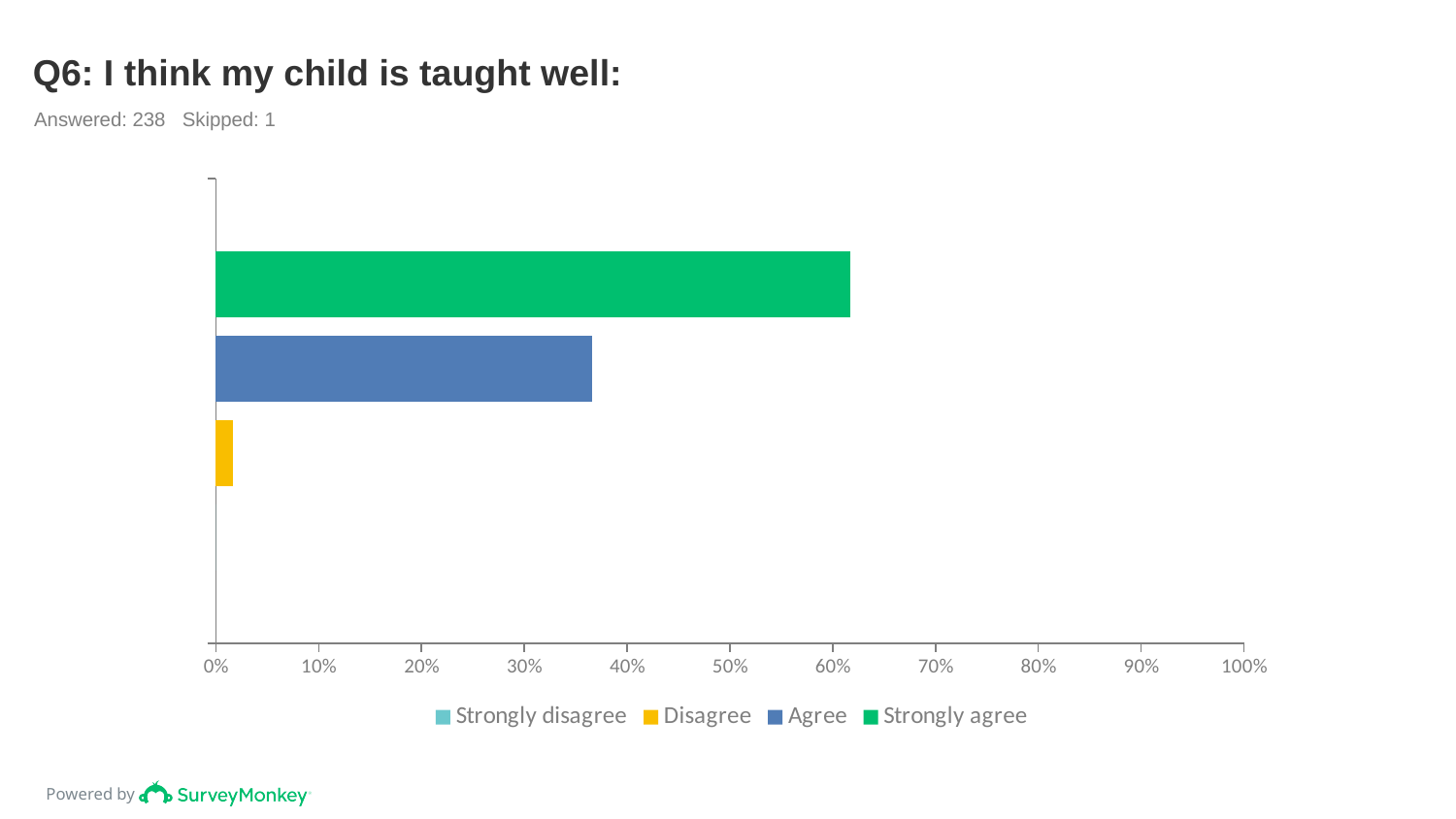
Which is larger, the value for Agree or the value for Strongly agree? Strongly agree Is the value for Disagree greater or less than 10%? less What is the title of the chart? Q6: I think my child is taught well: What kind of chart is shown on the slide? bar chart Is the value for Agree greater or less than 40%? less What colour is the bar for Strongly agree? green Is the value for Strongly agree greater or less than 50%? greater Which response has the highest value? Strongly agree How many series does the legend list? 4 Which is larger, the value for Disagree or the value for Agree? Agree